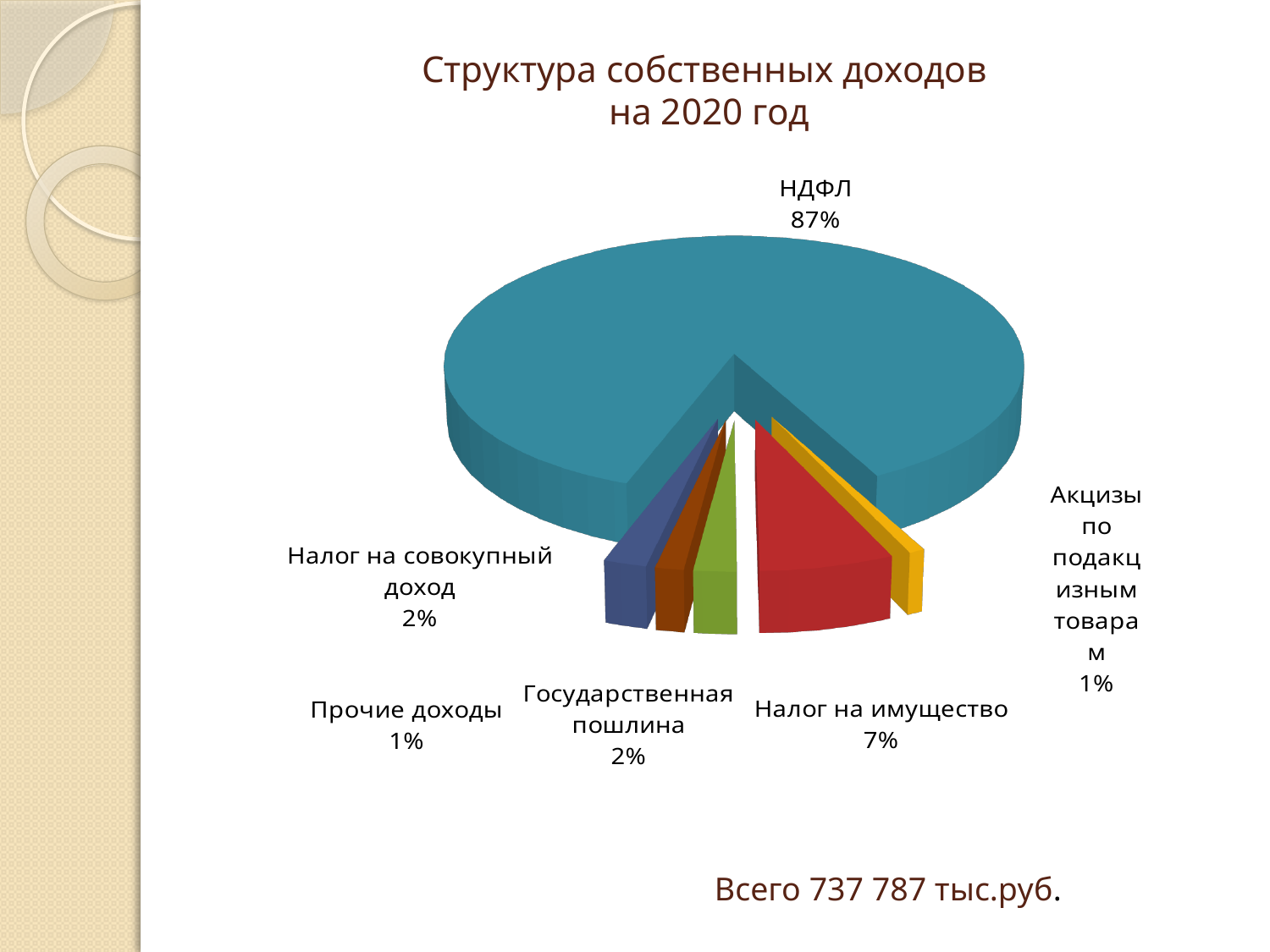
What share does Налог на имущество have in the pie chart? 7% What share does Прочие доходы have? 1% What percentage is shown for Государственная пошлина? 2% How many categories are shown in the pie chart? 6 Which category has the largest slice of the pie? НДФЛ Which is larger, Налог на имущество or Налог на совокупный доход? Налог на имущество What total amount is stated below the chart? 737 787 тыс.руб. What is the difference in percentage points between НДФЛ and Налог на имущество? 80 What kind of chart is shown on the slide? Pie chart What share of own revenues does НДФЛ account for? 87% What percentage is shown for Акцизы по подакцизным товарам? 1% What is the title of the chart? Структура собственных доходов на 2020 год